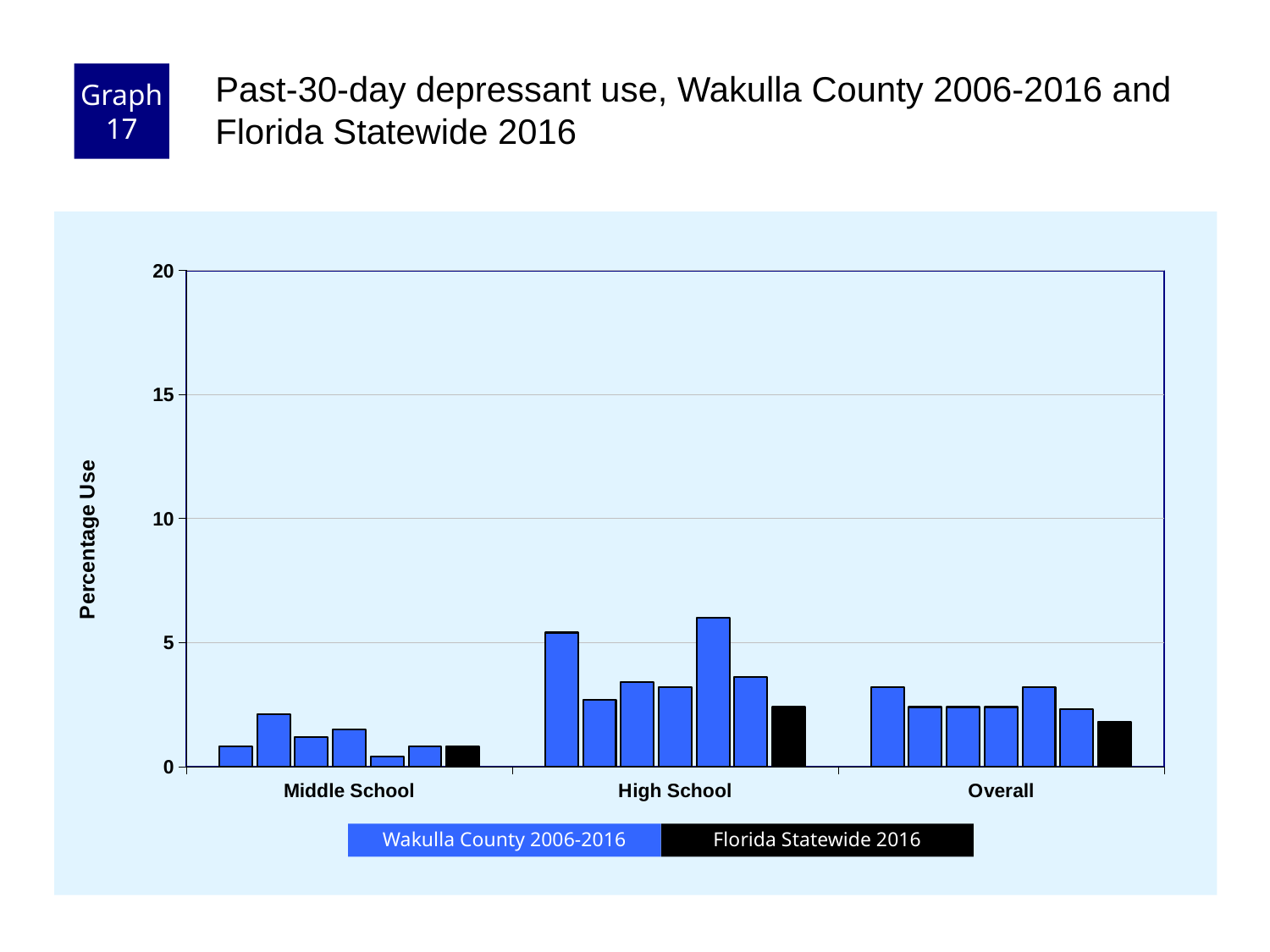
Are all the Middle School bars greater or less than 5? less Is the Florida Statewide 2016 value for Overall greater or less than 5? less What kind of chart is shown on the slide? bar chart How many series does the legend list? 2 Which is larger, the Florida Statewide 2016 bar for High School or the Florida Statewide 2016 bar for Middle School? High School How many categories are shown along the x axis? 3 Is the tallest Wakulla County bar in the High School group greater or less than 5? greater What is the label on the y axis? Percentage Use Which category contains the tallest bar in the chart? High School Which category contains the shortest bar in the chart? Middle School What colour represents Florida Statewide 2016 in the legend? black